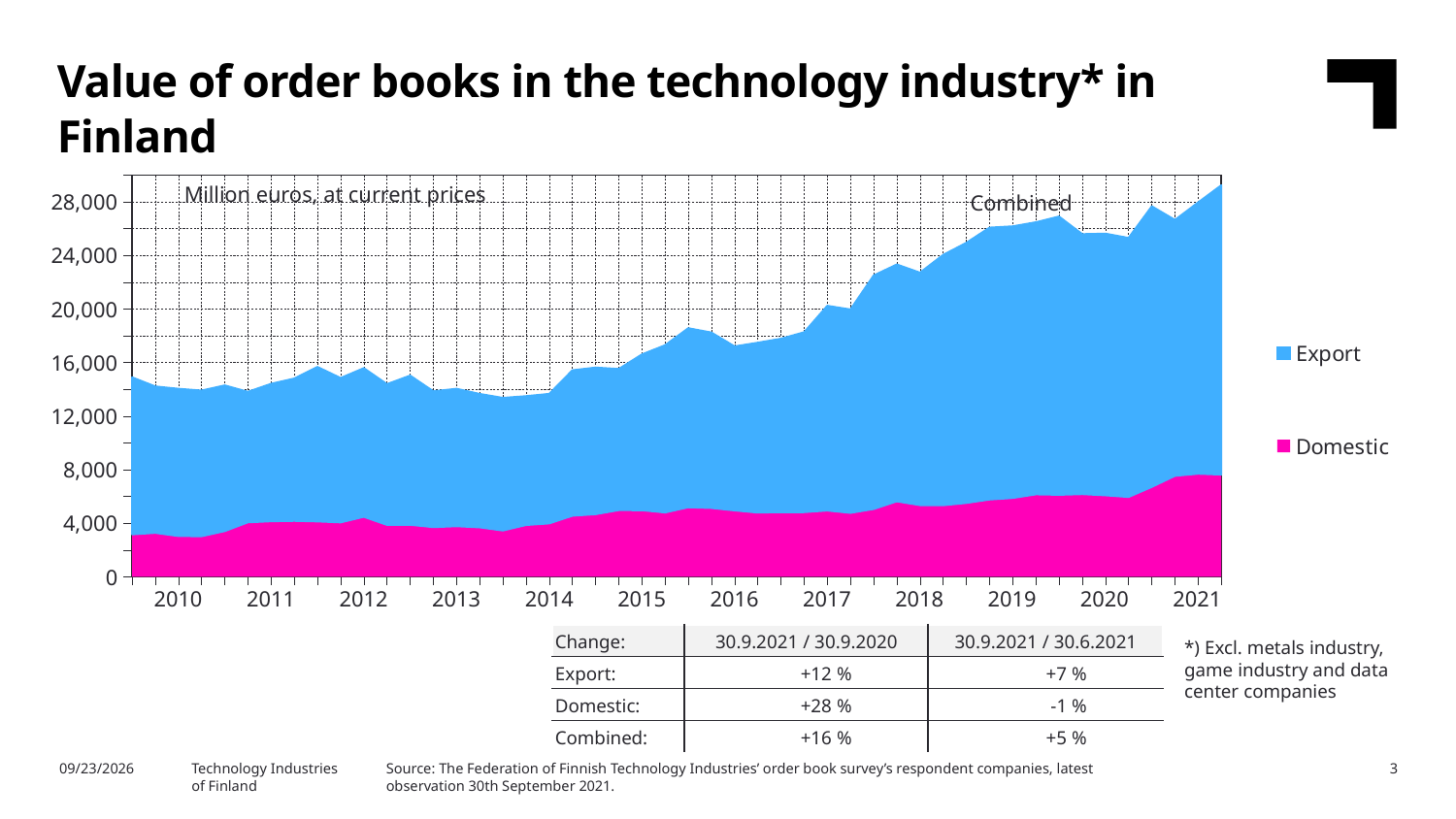
What kind of chart is shown on the slide? Area chart What unit does the chart's subtitle say the values are in? Million euros, at current prices Which two series are listed in the chart's legend? Export and Domestic Is the combined value at the start of 2018 greater or less than 20,000? greater Does the combined value of order books generally rise or fall from 2010 to 2021? rise Is the Domestic value at the end of 2021 greater or less than 8,000? less How many year labels are shown on the x axis of the chart? 12 At the end of 2021, which series is larger, Export or Domestic? Export Is the Domestic value at the start of 2010 greater or less than 4,000? less In which year does the combined value of order books reach its highest point? 2021 How many series does the chart's legend list? 2